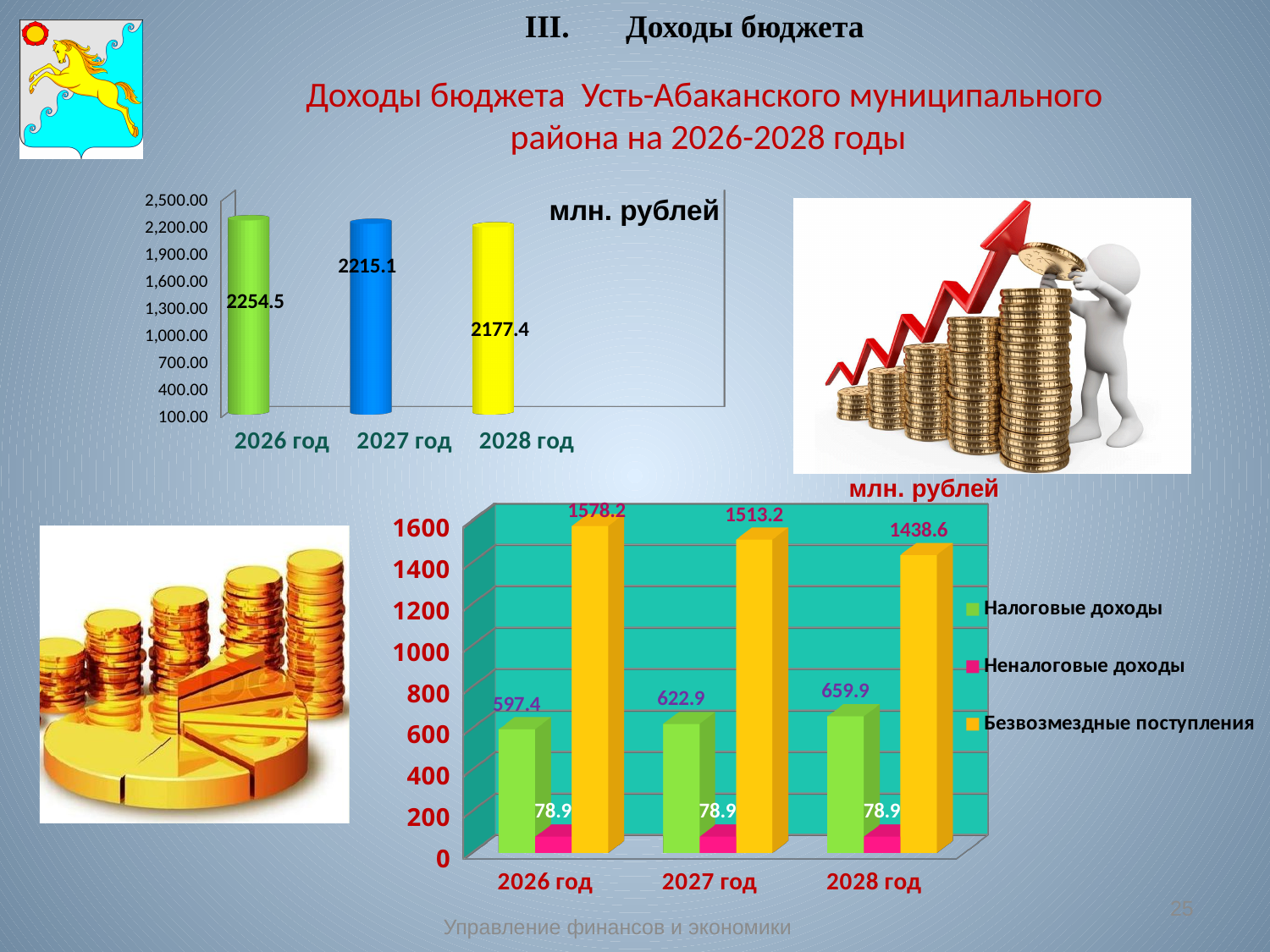
In the bottom-right chart, what is the value of Налоговые доходы for 2027 год? 622.9 In the top-left chart, do the values rise or fall from 2026 год to 2028 год? fall In the top-left chart, how many years are shown? 3 In the bottom-right chart, which series has the lowest value in 2026 год? Неналоговые доходы In the top-left chart, which year has the highest value? 2026 год In the top-left chart, what is the value for 2028 год? 2177.4 In the top-left chart, what is the difference between the values for 2026 год and 2027 год? 39.4 In the bottom-right chart, how many series does the legend list? 3 In the bottom-right chart, what is the value of Безвозмездные поступления for 2028 год? 1438.6 What type of chart is the bottom-right chart? bar chart In the top-left chart, what is the value for 2026 год? 2254.5 In the bottom-right chart, what is the difference between Безвозмездные поступления in 2026 год and 2027 год? 65.0